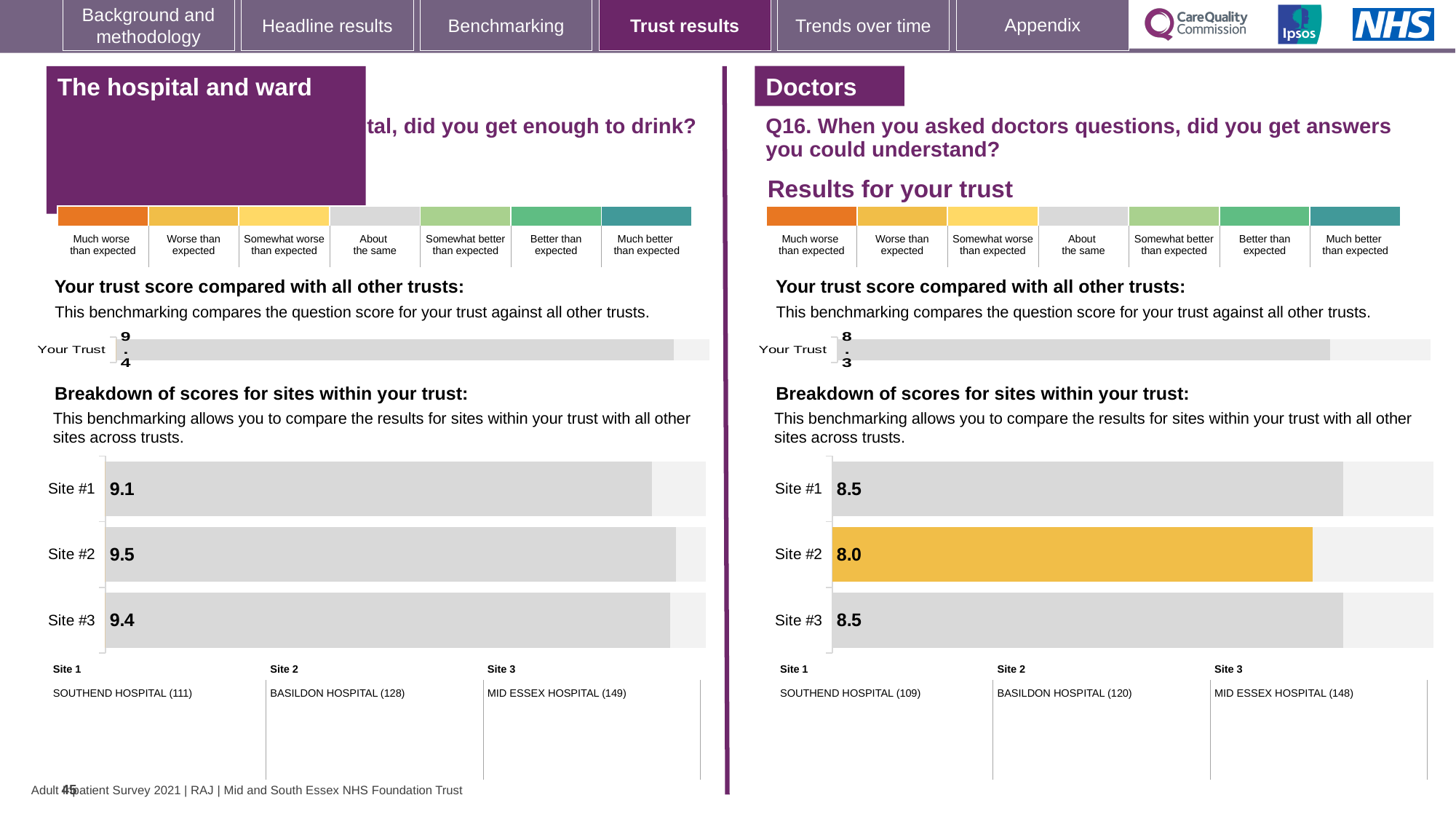
In the left-hand 'Your trust score compared with all other trusts' chart, what is the Your Trust score? 9.4 In the left-hand site breakdown chart, which site has the highest score? Site #2 How many sites are shown in the left-hand site breakdown chart? 3 In the left-hand site breakdown chart, what is the difference between the scores for Site #2 and Site #1? 0.4 In the right-hand (Q16) site breakdown chart, which is larger: the score for Site #1 or Site #2? Site #1 In the right-hand (Q16) site breakdown chart, what is the difference between the scores for Site #1 and Site #2? 0.5 In the right-hand (Q16) 'Your trust score compared with all other trusts' chart, what is the Your Trust score? 8.3 In the left-hand site breakdown chart (hospital and ward question), what is the score for Site #1? 9.1 In the right-hand (Q16) site breakdown chart, which site has the lowest score? Site #2 In the right-hand (Q16) site breakdown chart, which site's bar is coloured yellow rather than grey? Site #2 What kind of chart is used for the site breakdown on the right-hand (Q16) side of the slide? Bar chart In the right-hand (Q16, Doctors) site breakdown chart, what is the score for Site #2? 8.0